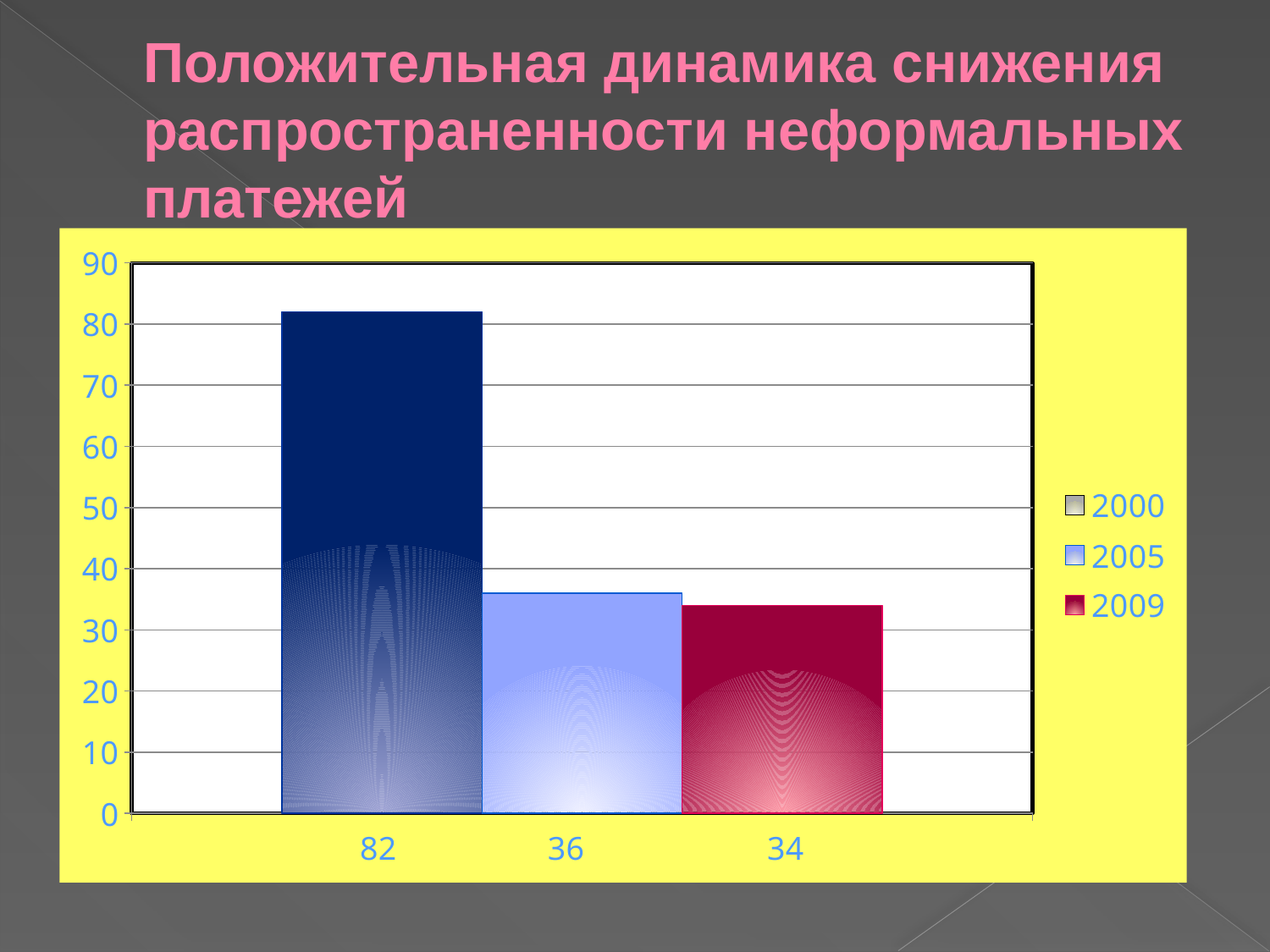
What is the value for 2000? 82 Which year has the lowest value? 2009 Is the value for 2005 greater or less than 40? less What is the value for 2005? 36 Which is larger, the value for 2000 or the value for 2009? 2000 How many bars are plotted on the chart? 3 Which year has the highest value? 2000 What is the difference between the values for 2000 and 2005? 46 What is the difference between the values for 2005 and 2009? 2 What kind of chart is shown on the slide? bar chart How many series does the legend list? 3 What is the value for 2009? 34